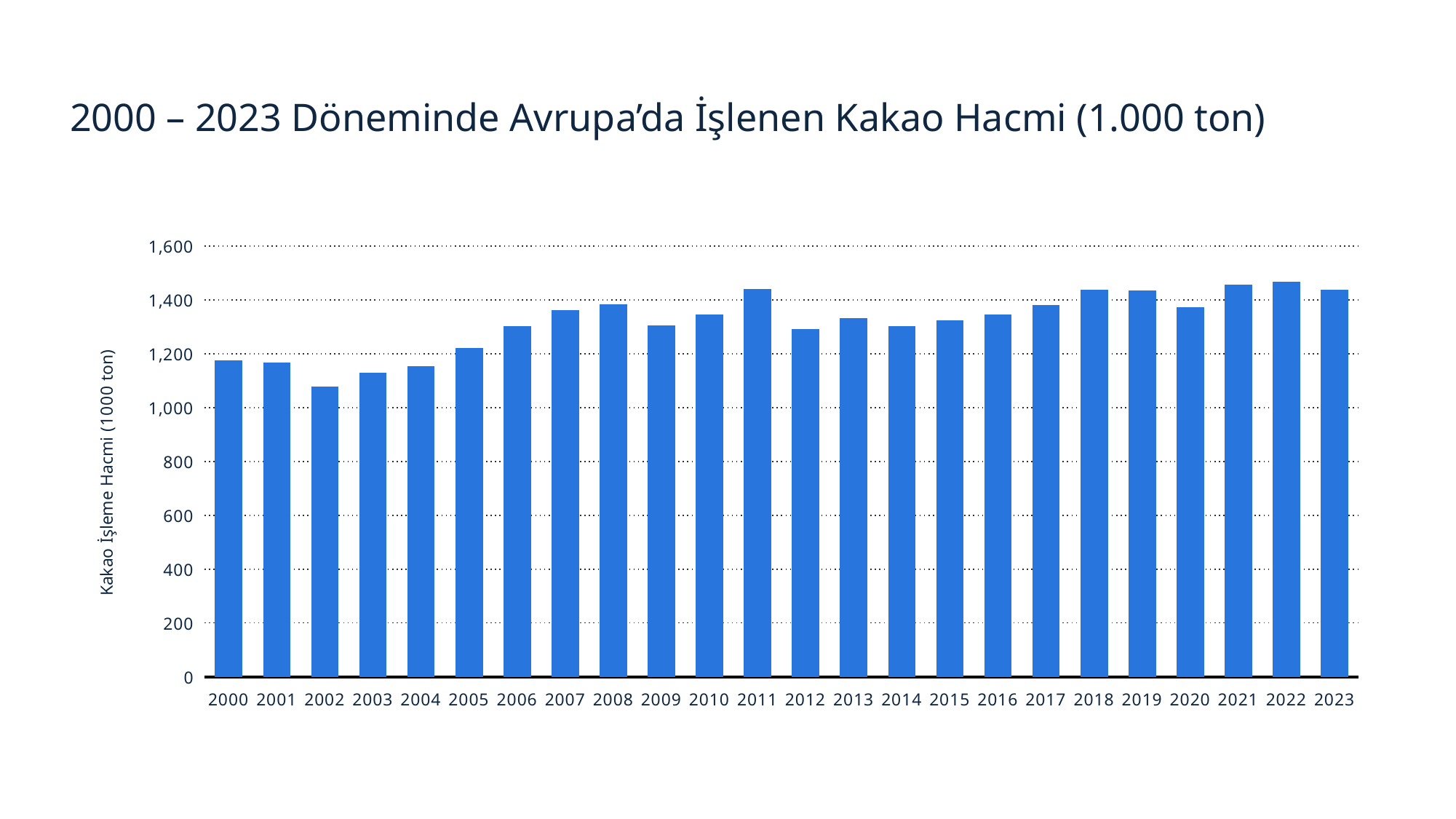
Is the value for 2020 greater or less than 1,400? less How many years (bars) are plotted in the chart? 24 Which year has the larger value, 2005 or 2008? 2008 What kind of chart is shown on the slide? Bar chart Overall, do the values rise or fall from 2000 to 2023? rise Is the value for 2011 greater or less than 1,400? greater Is the value for 2002 greater or less than 1,200? less Which year has the larger value, 2002 or 2011? 2011 Which year has the lowest processed cocoa volume? 2002 What is the label of the vertical axis? Kakao İşleme Hacmi (1000 ton)